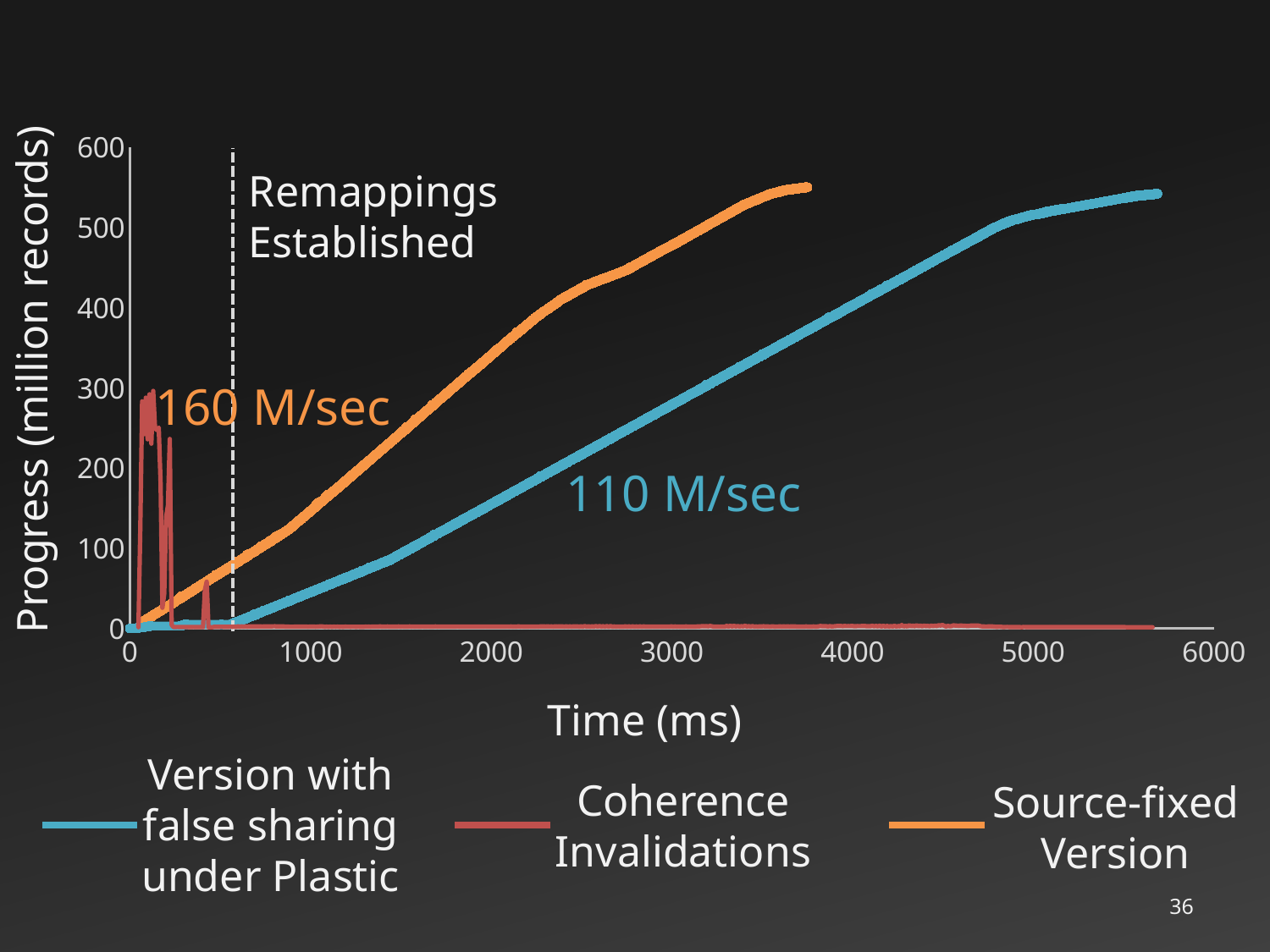
What rate is annotated next to the Source-fixed Version line? 160 M/sec Is the value of the Source-fixed Version at 2000 ms greater or less than 300? greater What is the label of the x axis? Time (ms) How many series does the legend list? 3 Which series reaches 500 million records first, Source-fixed Version or Version with false sharing under Plastic? Source-fixed Version Which series has the higher annotated rate, Source-fixed Version or Version with false sharing under Plastic? Source-fixed Version What is the label of the y axis? Progress (million records) What is the difference between the two annotated rates, 160 M/sec and 110 M/sec? 50 M/sec Is the value of the Version with false sharing under Plastic at 2000 ms greater or less than 200? less Does the Source-fixed Version line rise or fall as time increases? rise What kind of chart is shown on the slide? line chart What rate is annotated next to the Version with false sharing under Plastic line? 110 M/sec